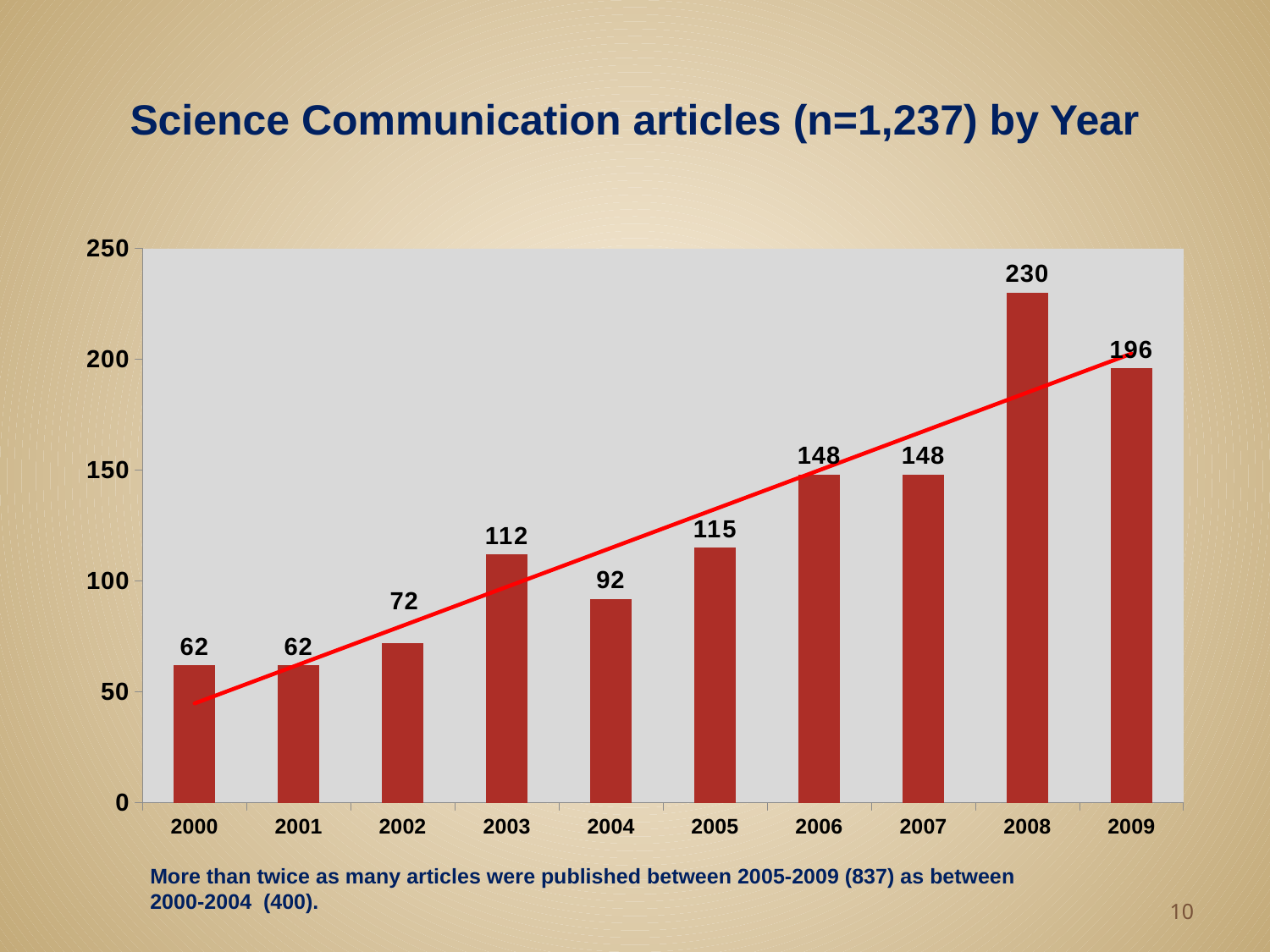
What colour are the bars in the chart? red Which year has the highest number of articles? 2008 How many years are shown on the x axis? 10 What is the number of Science Communication articles in 2008? 230 Do the values generally rise or fall from 2000 to 2009? rise Which year has more articles, 2003 or 2004? 2003 What is the difference between the number of articles in 2008 and in 2009? 34 What is the difference between the number of articles in 2003 and in 2002? 40 What kind of chart is shown on the slide? bar chart What is the title of the chart? Science Communication articles (n=1,237) by Year Is the value for 2005 greater or less than 100? greater What is the number of Science Communication articles in 2004? 92